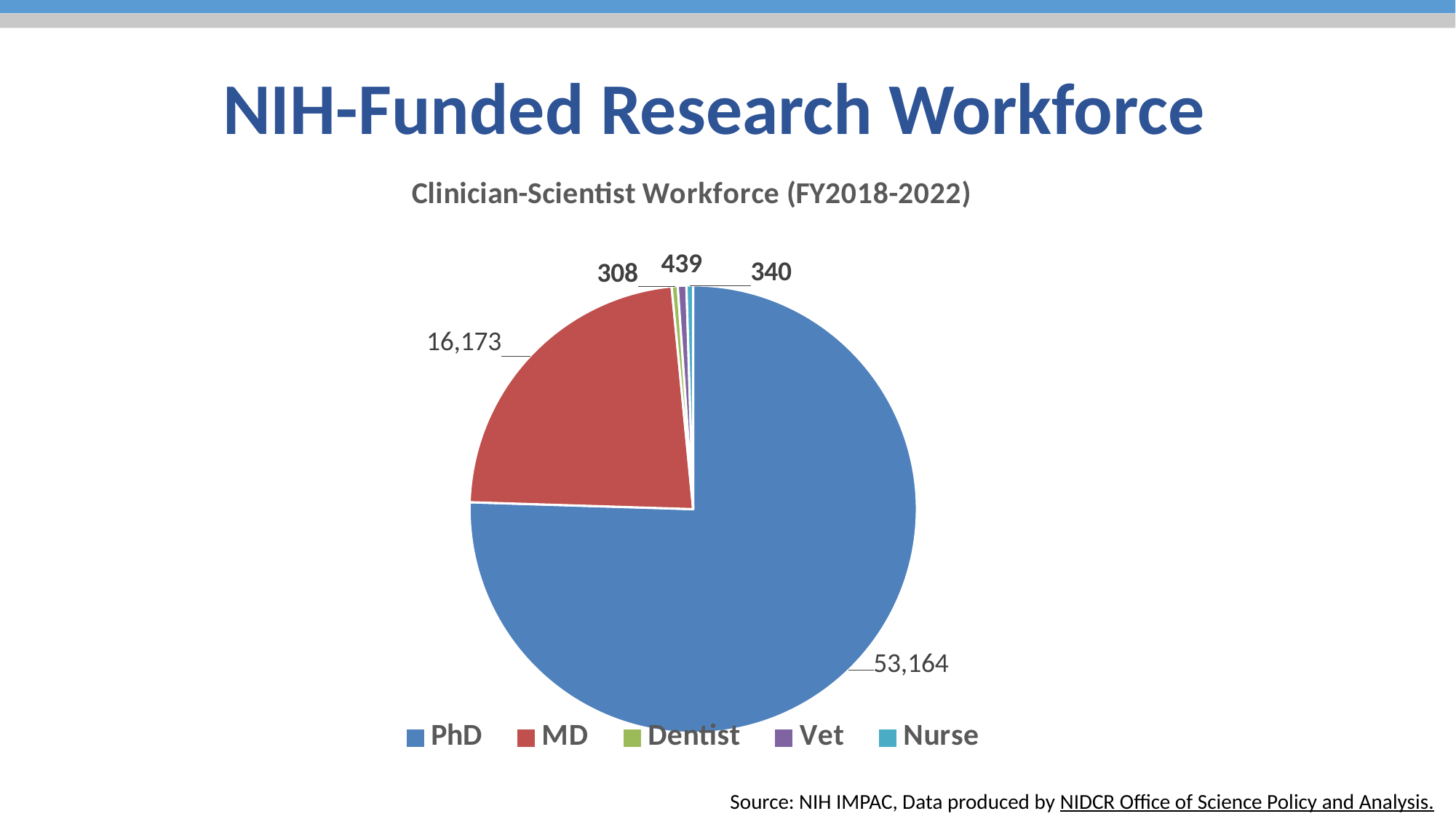
What is the value for Vet? 439 Which category has the largest slice? PhD What type of chart is shown on the slide? Pie chart What is the value for Nurse? 340 What is the value for Dentist? 308 Which is larger, the value for Vet or the value for Nurse? Vet What is the difference between the PhD and MD values? 36,991 How many categories does the legend list? 5 What is the title of the chart? Clinician-Scientist Workforce (FY2018-2022) Which category has the smallest value? Dentist What is the value for MD? 16,173 What is the value for PhD? 53,164